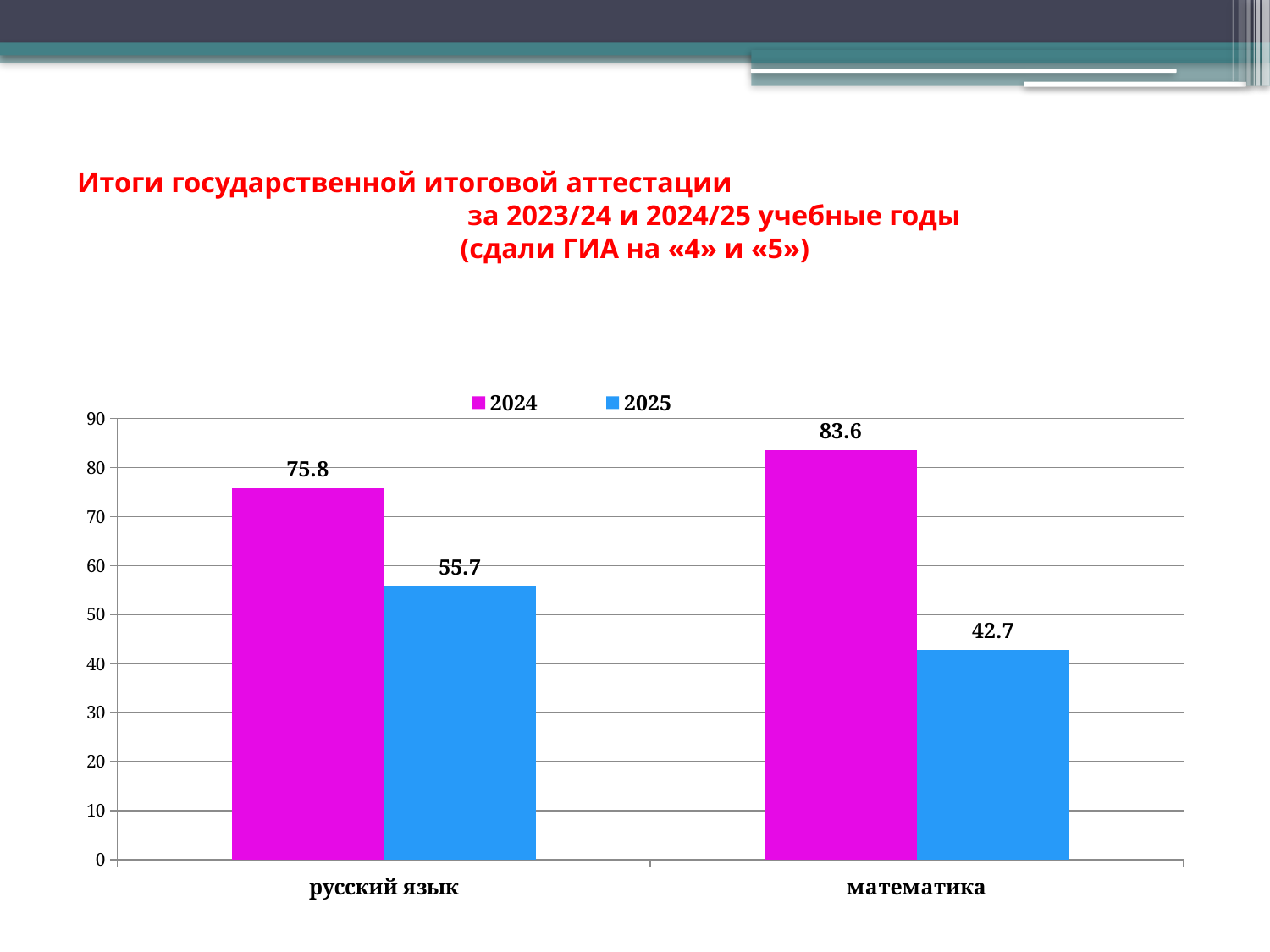
What is the value for русский язык in the 2024 series? 75.8 What is the value for русский язык in the 2025 series? 55.7 Which category has the lowest value in the 2025 series? математика Which category has the highest value in the 2024 series? математика What is the value for математика in the 2025 series? 42.7 What is the difference between the 2024 and 2025 values for русский язык? 20.1 Which is larger: the 2025 value for русский язык or the 2025 value for математика? русский язык What is the difference between the 2024 and 2025 values for математика? 40.9 How many categories are shown on the x axis? 2 Is the 2024 value for математика greater or less than 80? greater What kind of chart is shown on the slide? bar chart How many series does the legend list? 2